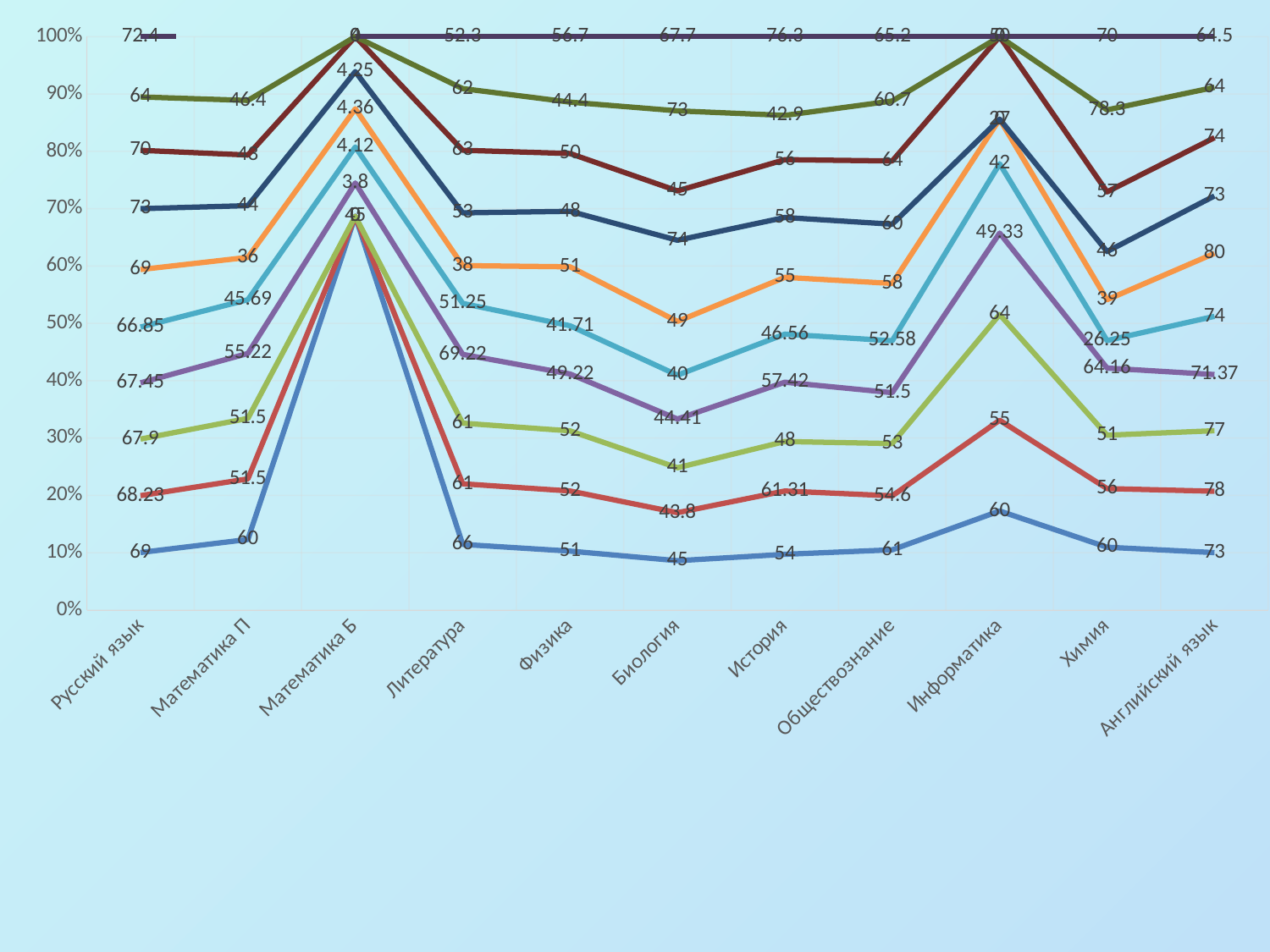
What kind of chart is shown on the slide? line chart What is the first category on the x axis? Русский язык What is the data label of the bottom (blue) line for Литература? 66 For the bottom (blue) line, what is the difference between the values for Английский язык (73) and Биология (45)? 28 What is the data label of the bottom (blue) line for Английский язык? 73 What is the data label of the top (dark purple) line for История? 76.3 How many categories (subjects) are shown along the x axis? 11 What is the data label of the bottom (blue) line for Русский язык? 69 For the bottom (blue) line, which is larger: the value for Английский язык or the value for Физика? Английский язык What is the data label of the bottom (blue) line for Биология? 45 What is the data label of the top (dark purple) line for Русский язык? 72.4 What is the last category on the x axis? Английский язык